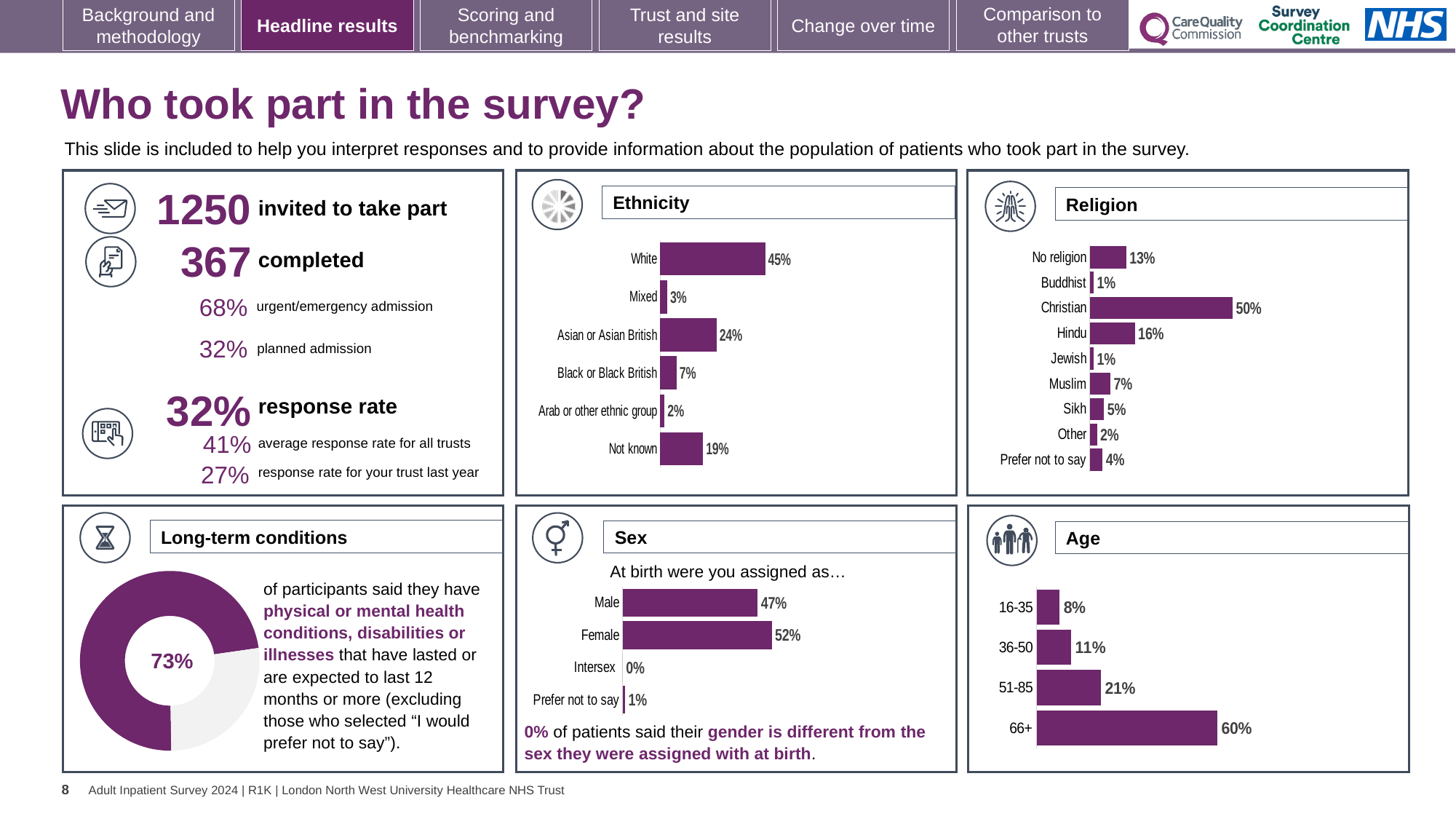
In the Ethnicity chart, which category has the lowest value? Arab or other ethnic group In the Religion chart, which is larger, Muslim or Sikh? Muslim In the Sex chart, what is the difference between Female and Male? 5% In the Ethnicity chart, what is the difference between Asian or Asian British and Black or Black British? 17% In the Religion chart, which category has the highest value? Christian In the Sex chart, what is the value for Female? 52% In the Ethnicity chart, what is the value for White? 45% In the Age chart, do the values rise or fall from 16-35 to 66+? rise In the Religion chart, what is the value for Hindu? 16% In the Age chart, what is the value for 51-85? 21% How many categories does the Religion chart show? 9 What kind of chart is the Long-term conditions chart? doughnut chart